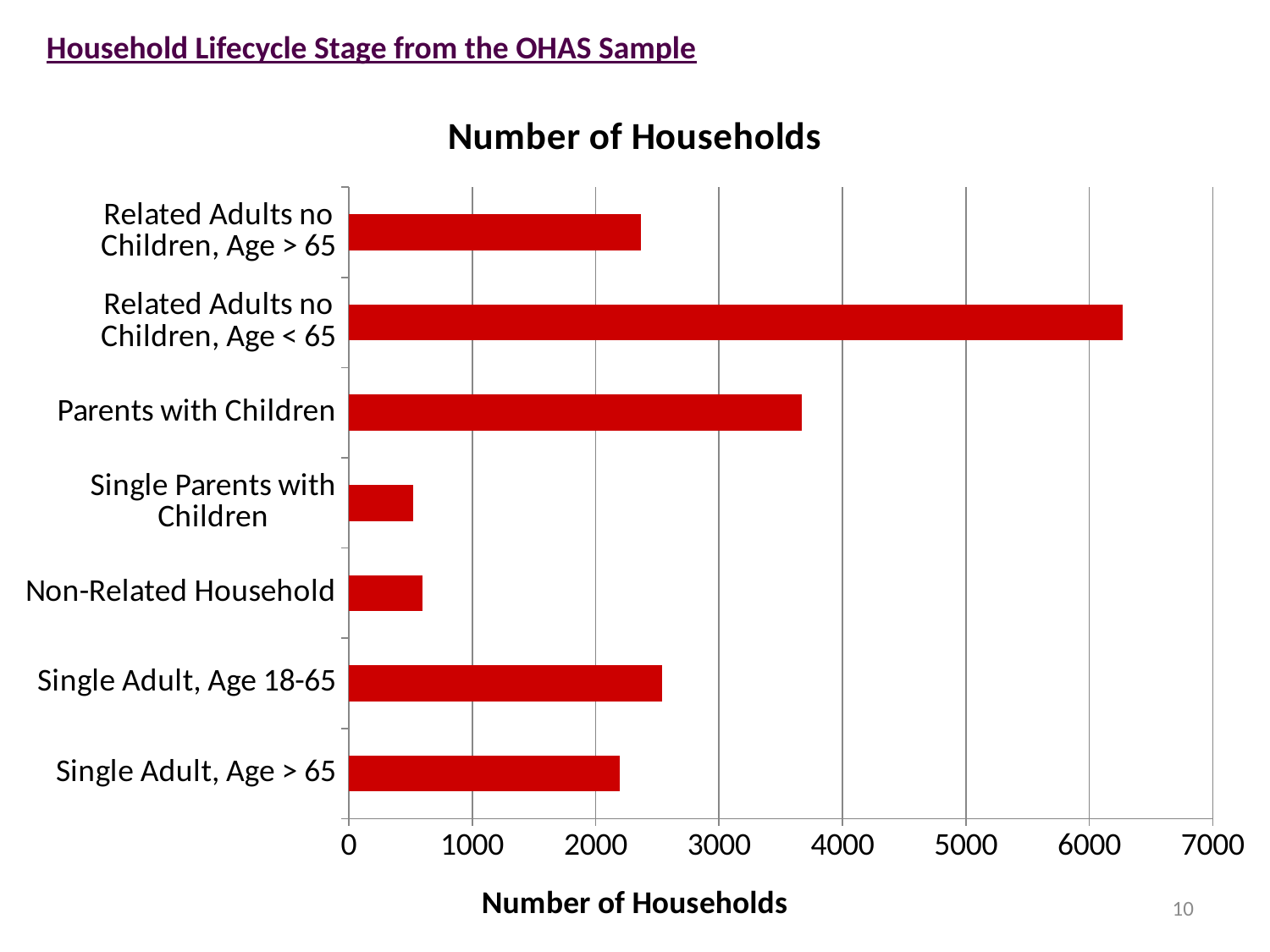
What type of chart is shown on the slide? bar chart How many household lifecycle categories are plotted in the chart? 7 Is the value for Non-Related Household greater or less than 1000? less Is the value for Parents with Children greater or less than 3000? greater Is the value for Single Parents with Children greater or less than 1000? less Which category has the highest number of households? Related Adults no Children, Age < 65 Which has more households: Single Adult, Age 18-65 or Single Adult, Age > 65? Single Adult, Age 18-65 What is the title of the chart? Number of Households Which has more households: Parents with Children or Single Adult, Age 18-65? Parents with Children